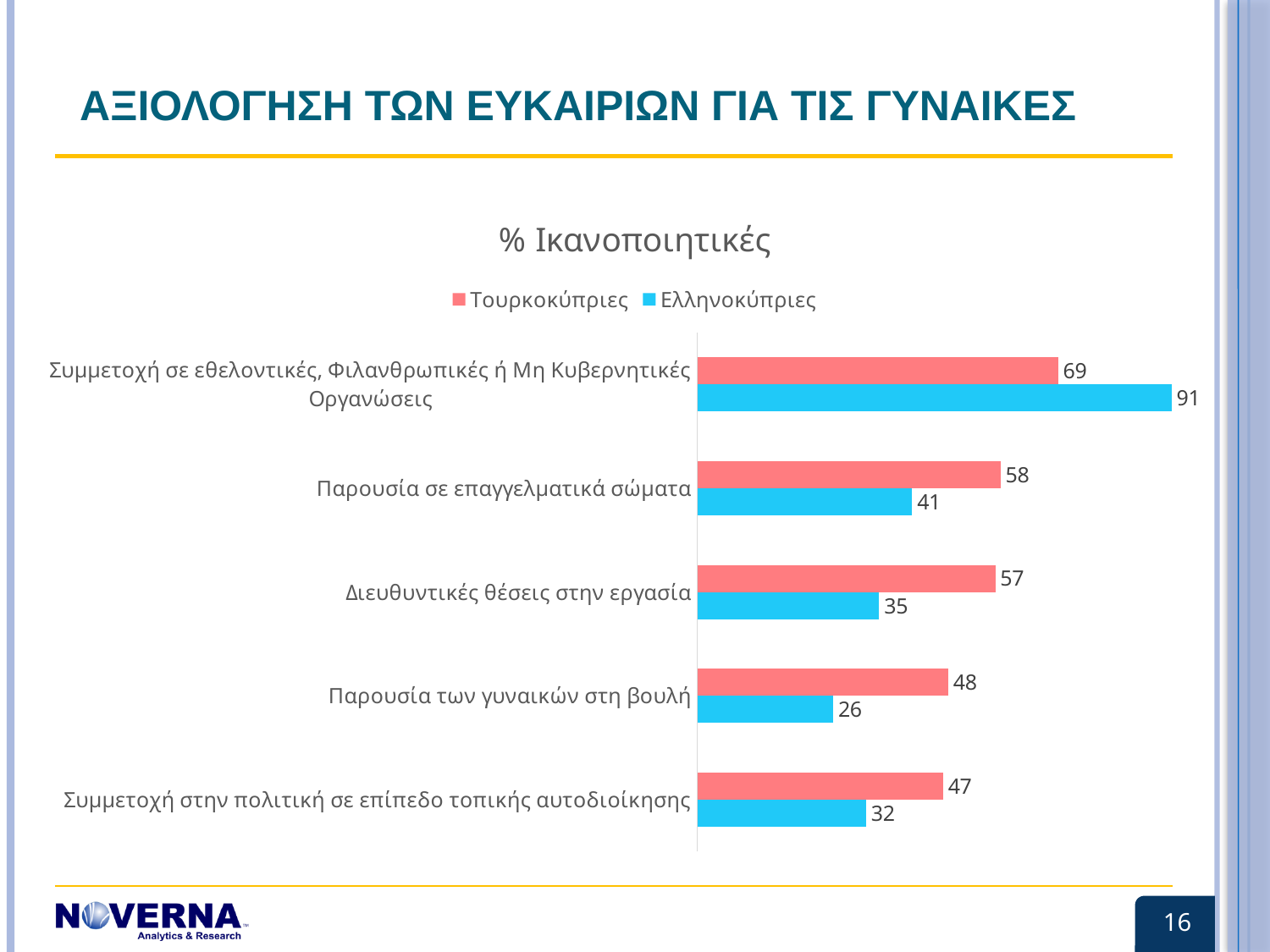
What is the value for Ελληνοκύπριες for 'Παρουσία των γυναικών στη βουλή'? 26 What is the value for Τουρκοκύπριες for 'Συμμετοχή στην πολιτική σε επίπεδο τοπικής αυτοδιοίκησης'? 47 What is the title of the chart? % Ικανοποιητικές Which category has the highest value for Ελληνοκύπριες? Συμμετοχή σε εθελοντικές, Φιλανθρωπικές ή Μη Κυβερνητικές Οργανώσεις For 'Παρουσία σε επαγγελματικά σώματα', which series has the larger value, Τουρκοκύπριες or Ελληνοκύπριες? Τουρκοκύπριες How many series does the legend list? 2 What is the difference between the Ελληνοκύπριες and Τουρκοκύπριες values for 'Διευθυντικές θέσεις στην εργασία'? 22 What is the value for Ελληνοκύπριες for 'Συμμετοχή σε εθελοντικές, Φιλανθρωπικές ή Μη Κυβερνητικές Οργανώσεις'? 91 How many categories are shown in the chart? 5 What kind of chart is shown on the slide? Bar chart What is the value for Τουρκοκύπριες for 'Παρουσία σε επαγγελματικά σώματα'? 58 Which category has the lowest value for Τουρκοκύπριες? Συμμετοχή στην πολιτική σε επίπεδο τοπικής αυτοδιοίκησης